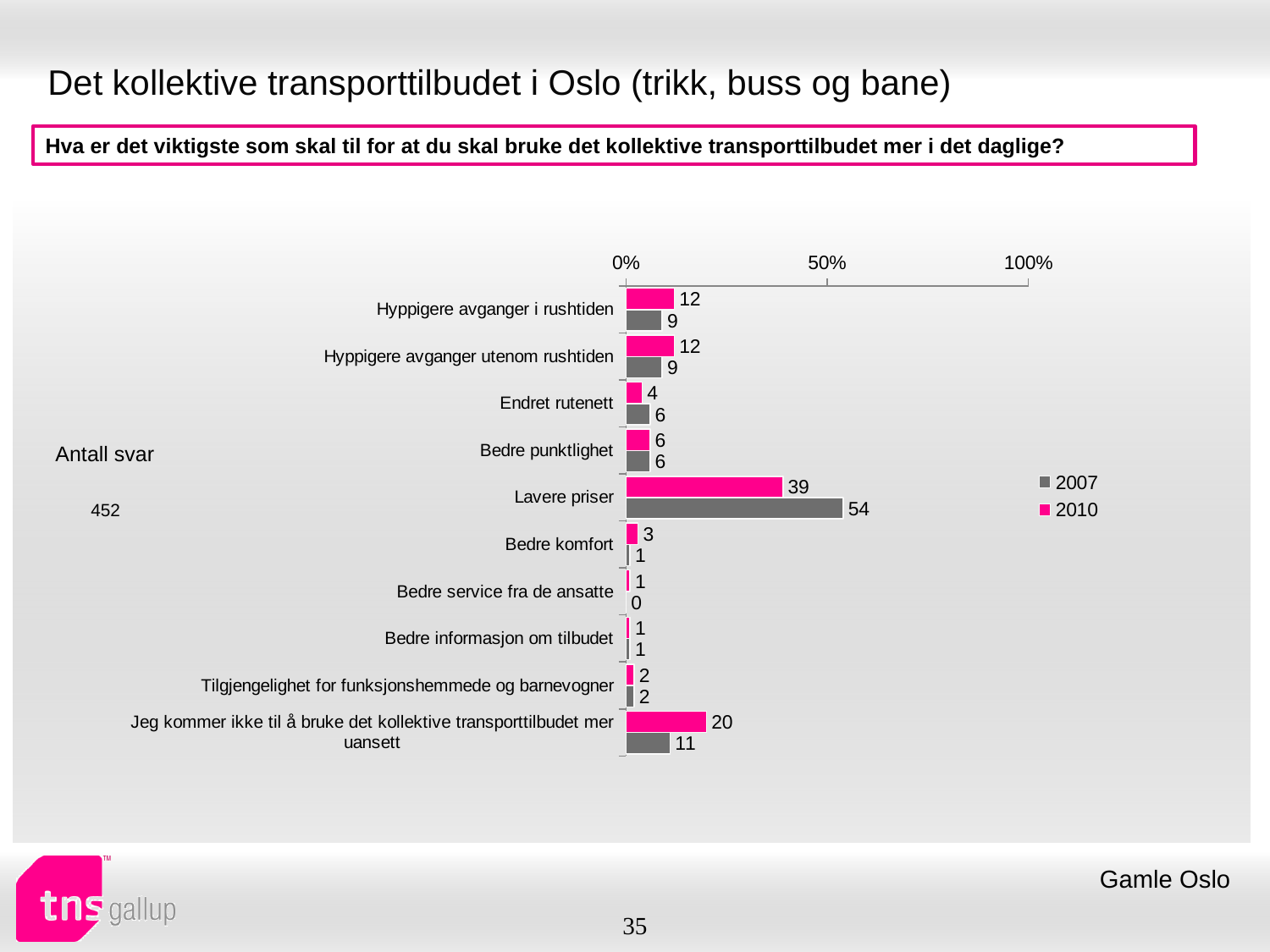
What is the 2007 value for "Lavere priser"? 54 How many series does the legend list? 2 What kind of chart is shown on the slide? bar chart For "Hyppigere avganger i rushtiden", which is larger, the 2007 value or the 2010 value? 2010 Which colour represents the 2010 series in the legend? pink Which category has the lowest 2007 value? Bedre service fra de ansatte Which category has the highest 2007 value? Lavere priser How many categories are shown in the chart? 10 What is the 2010 value for "Lavere priser"? 39 What is the 2010 value for "Jeg kommer ikke til å bruke det kollektive transporttilbudet mer uansett"? 20 What is the 2007 value for "Endret rutenett"? 6 What is the difference between the 2007 and 2010 values for "Lavere priser"? 15